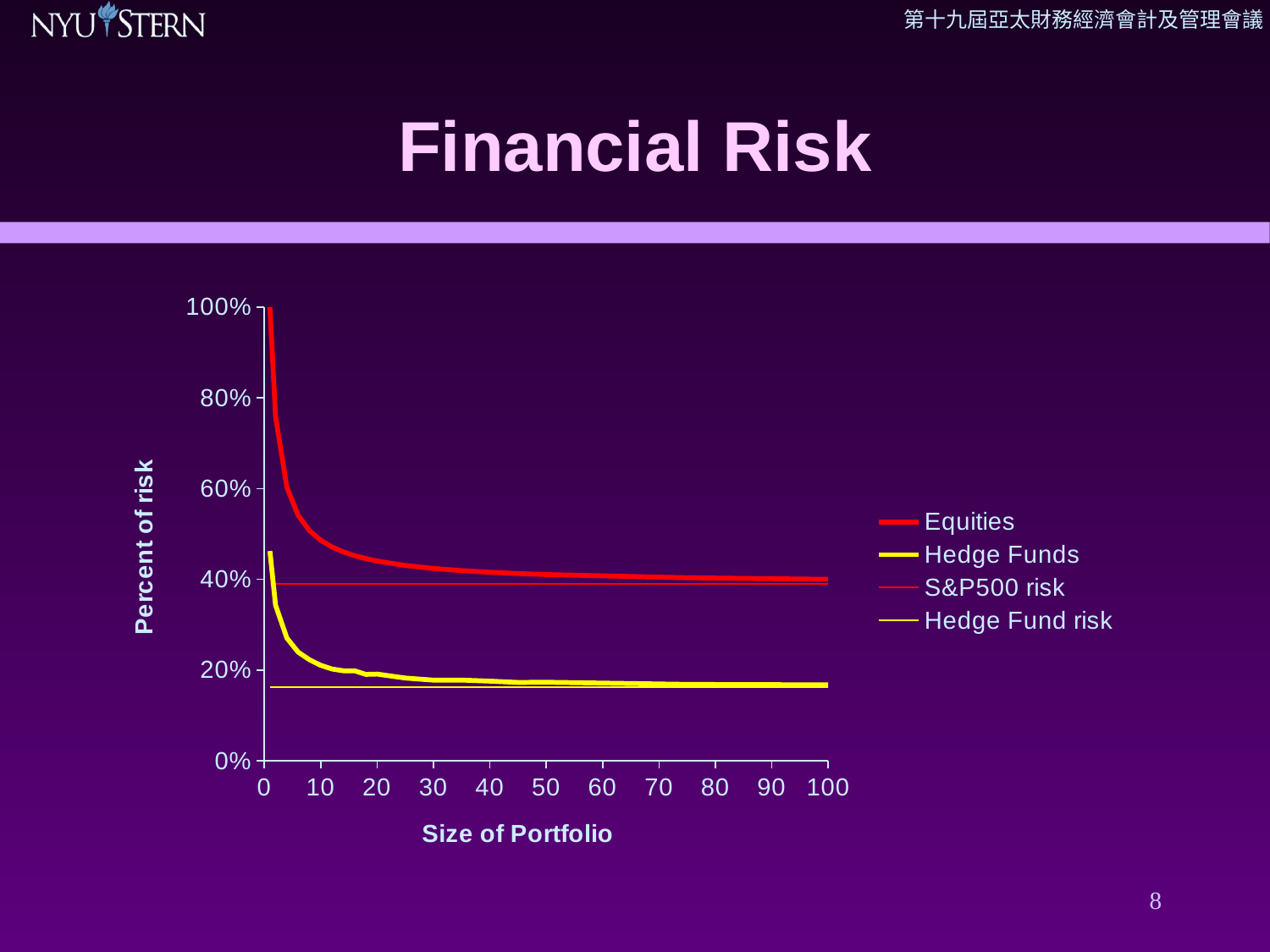
Is the value for Equities at a portfolio size of 10 greater or less than 20%? greater Is the value for Hedge Funds at a portfolio size of 10 greater or less than 40%? less How many series does the chart's legend list? 4 Is the value for Hedge Funds at a portfolio size of 100 greater or less than 20%? less What kind of chart is shown on the slide? Line chart Does the Equities line rise or fall as the size of portfolio increases? Fall Does the Hedge Funds line rise or fall as the size of portfolio increases? Fall At a portfolio size of 50, which is larger: Equities or Hedge Funds? Equities What is the title of the slide containing the chart? Financial Risk What is the label of the chart's x axis? Size of Portfolio